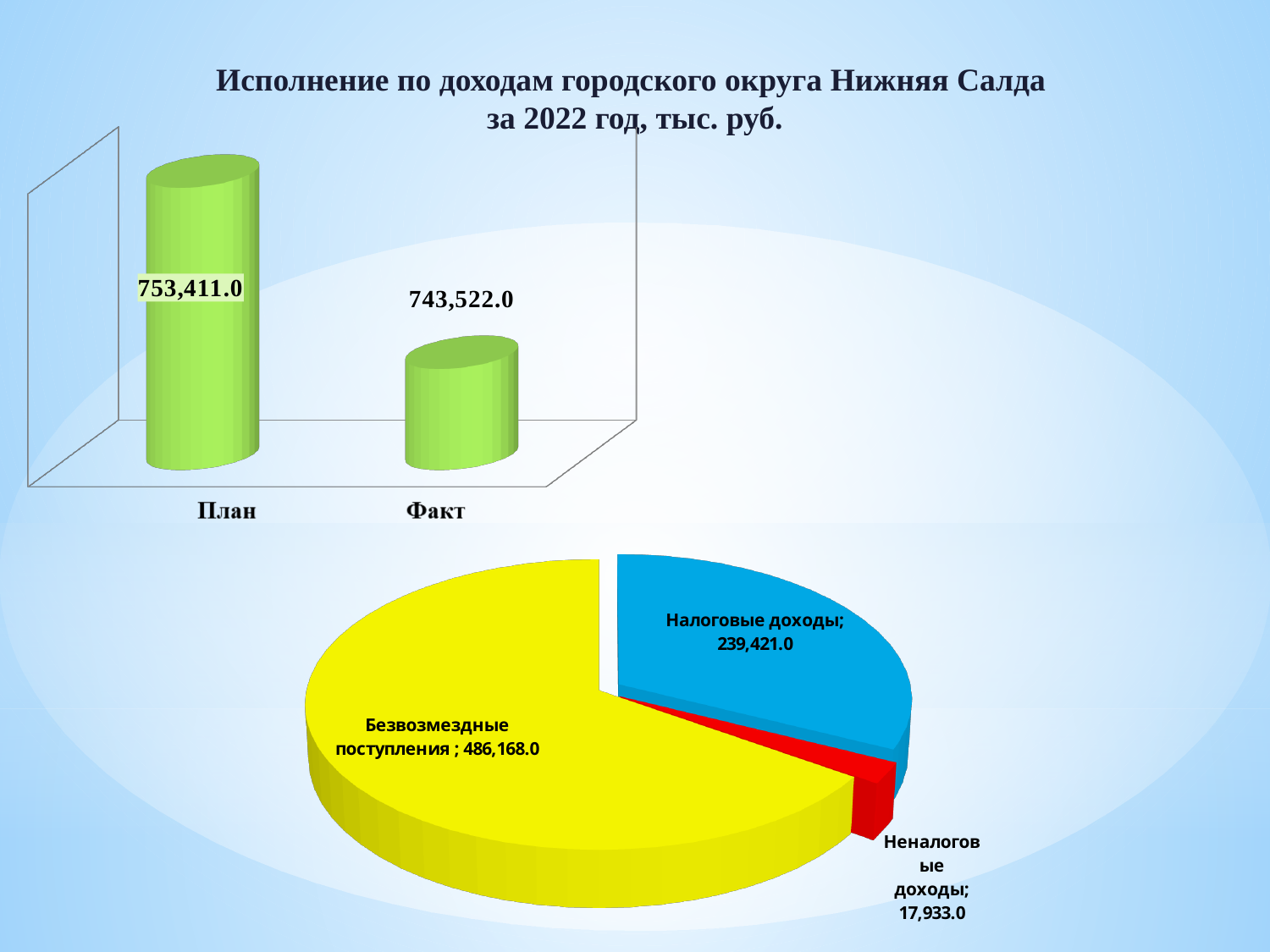
On the bottom pie chart, which slice is the largest? Безвозмездные поступления On the top bar chart, what is the difference between the План and Факт values? 9,889.0 On the bottom pie chart, how many slices are there? 3 What type of chart is the top chart on the slide? Bar chart On the bottom pie chart, what is the value for Налоговые доходы? 239,421.0 On the top bar chart, what is the value for Факт? 743,522.0 On the top bar chart, what is the value for План? 753,411.0 On the top bar chart, how many categories are shown? 2 On the bottom pie chart, which slice is the smallest? Неналоговые доходы On the top bar chart, which category has the higher value, План or Факт? План On the bottom pie chart, what is the value for Безвозмездные поступления? 486,168.0 What is the title of the slide's chart? Исполнение по доходам городского округа Нижняя Салда за 2022 год, тыс. руб.